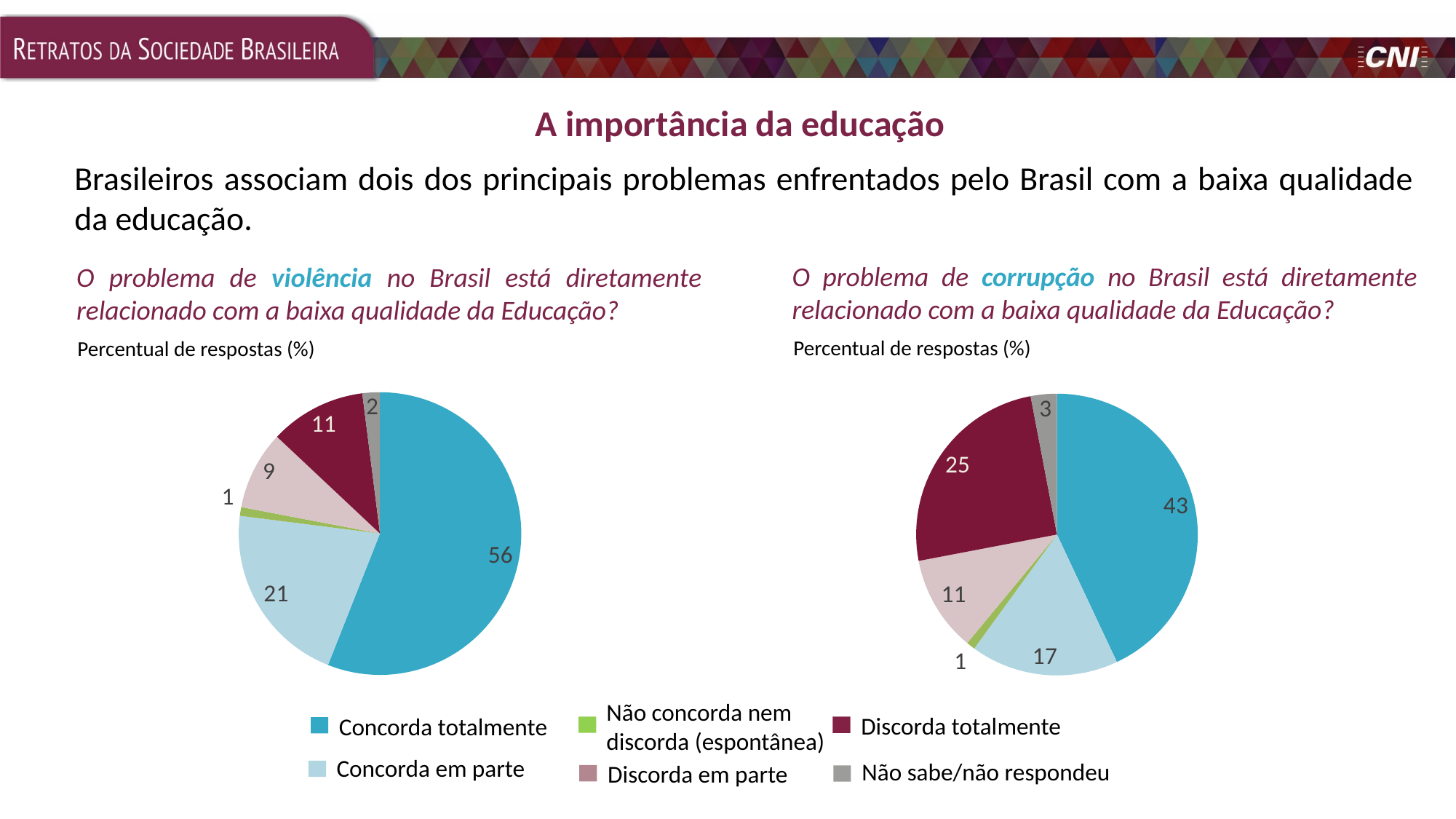
In the right pie chart about corrupção, what is the value for Concorda em parte? 17 In the right pie chart about corrupção, which category has the smallest slice? Não concorda nem discorda (espontânea) How many categories does the shared legend list? 6 In the right pie chart about corrupção, which is larger: Discorda em parte or Concorda em parte? Concorda em parte In the left pie chart about violência, what is the value for Concorda totalmente? 56 In the right pie chart about corrupção, what is the value for Discorda totalmente? 25 What is the difference between Concorda totalmente in the left pie chart (violência) and Concorda totalmente in the right pie chart (corrupção)? 13 In the left pie chart about violência, which category has the largest slice? Concorda totalmente In the left pie chart about violência, what is the difference between Concorda em parte and Discorda totalmente? 10 Which is larger: Discorda totalmente in the left pie chart (violência) or Discorda totalmente in the right pie chart (corrupção)? Right pie chart (corrupção) In the left pie chart about violência, what is the value for Não sabe/não respondeu? 2 What type of chart is used on the left for the violência question? Pie chart